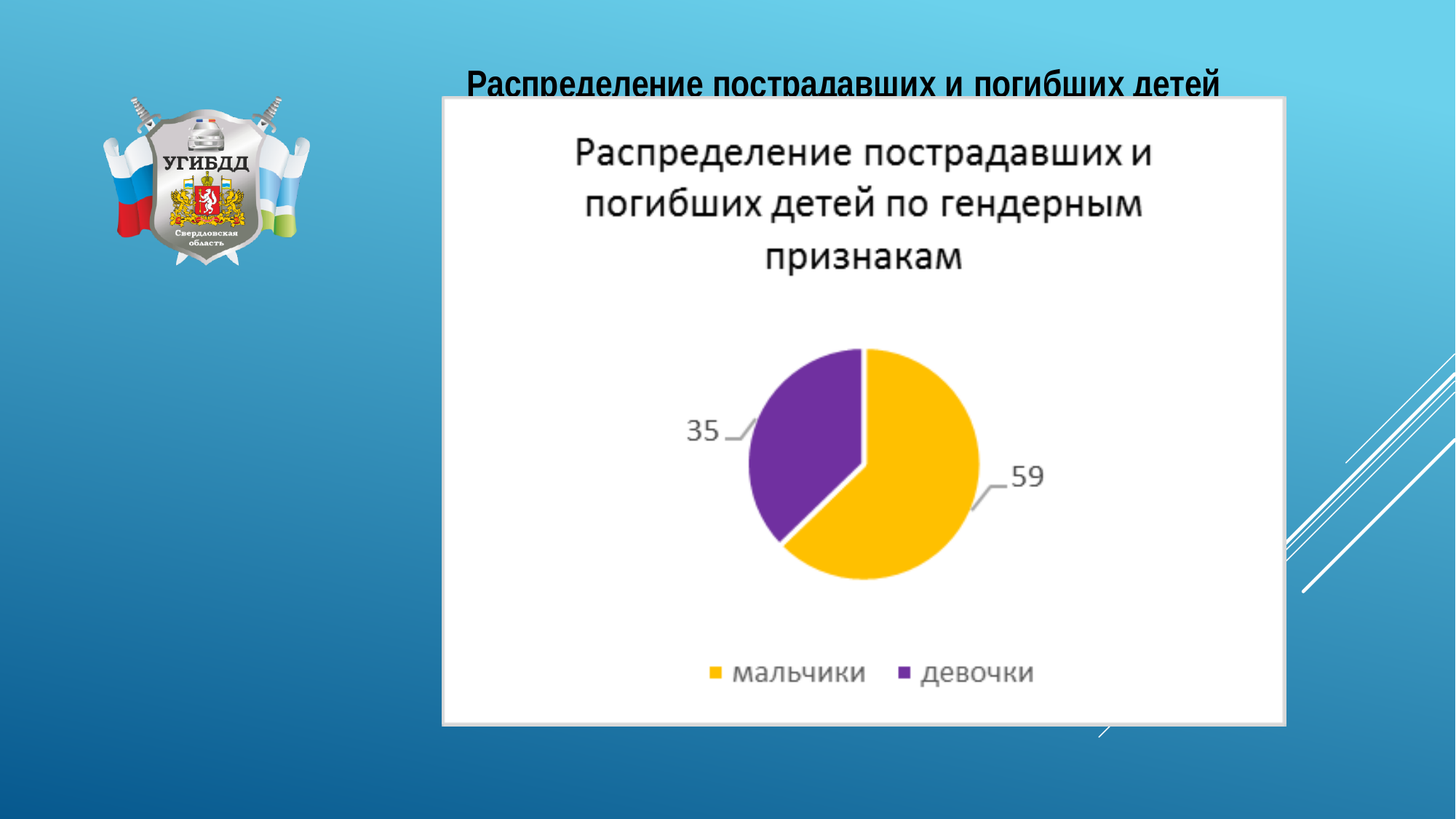
How many categories does the pie chart show? 2 What is the value for девочки in the pie chart? 35 Which is larger, the value for мальчики or the value for девочки? мальчики What is the difference between the values for мальчики and девочки? 24 What is the value for мальчики in the pie chart? 59 What colour is the slice for девочки? Purple What type of chart is shown on the slide? Pie chart Which category has the smallest slice in the pie chart? девочки Which category has the largest slice in the pie chart? мальчики What is the total of all slices in the pie chart? 94 How many entries does the legend list? 2 What is the title of the chart? Распределение пострадавших и погибших детей по гендерным признакам